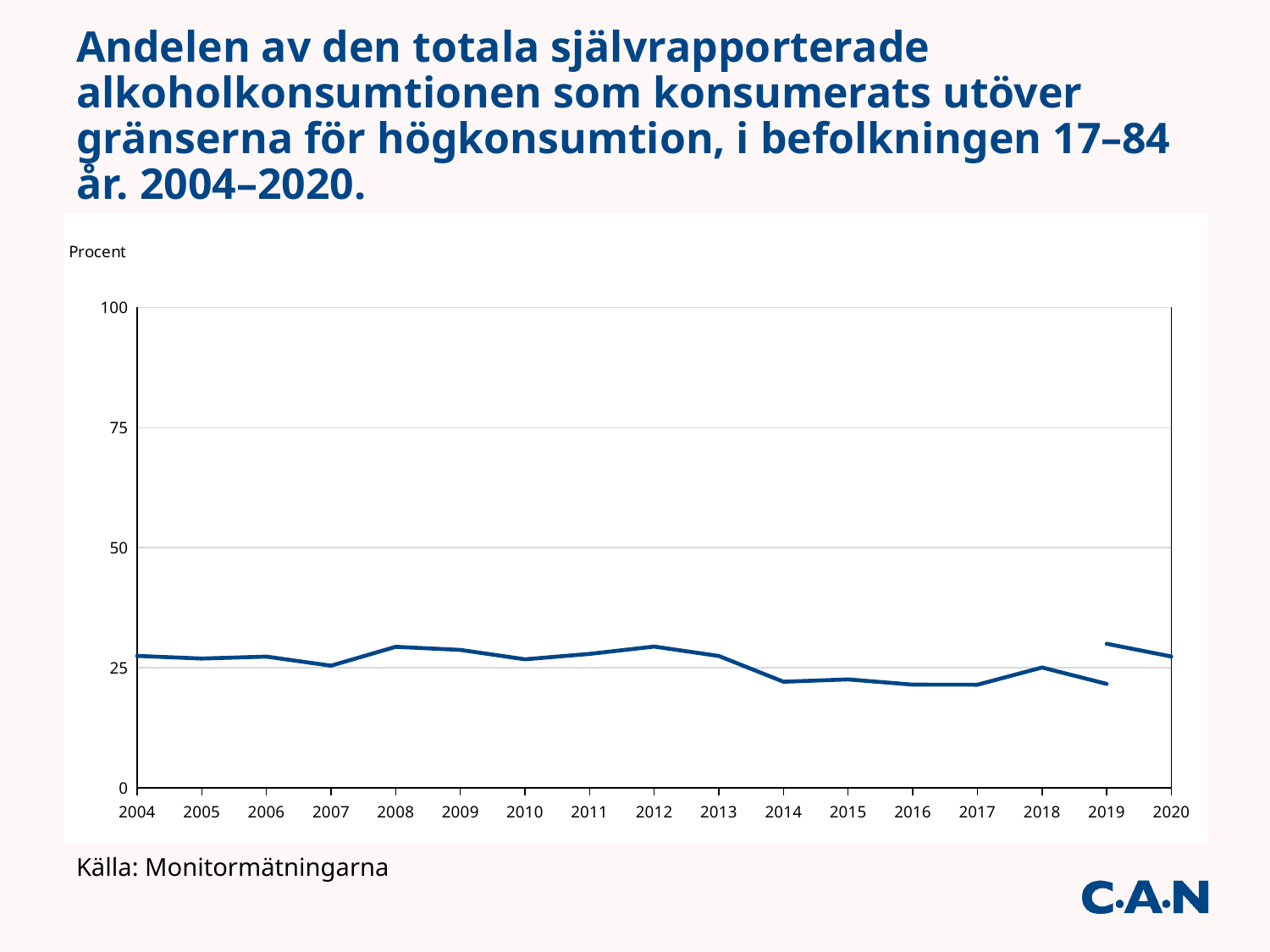
What is the label on the y axis of the chart? Procent Is the value for 2014 greater or less than 25? less How many years are labelled along the x axis of the chart? 17 Which year has the larger value, 2016 or 2012? 2012 Is the value for 2004 greater or less than 50? less Is the value for 2017 greater or less than 25? less What kind of chart is shown on the slide? line chart What source is given below the chart? Monitormätningarna Does the line rise or fall between 2012 and 2014? fall Which year has the larger value, 2008 or 2014? 2008